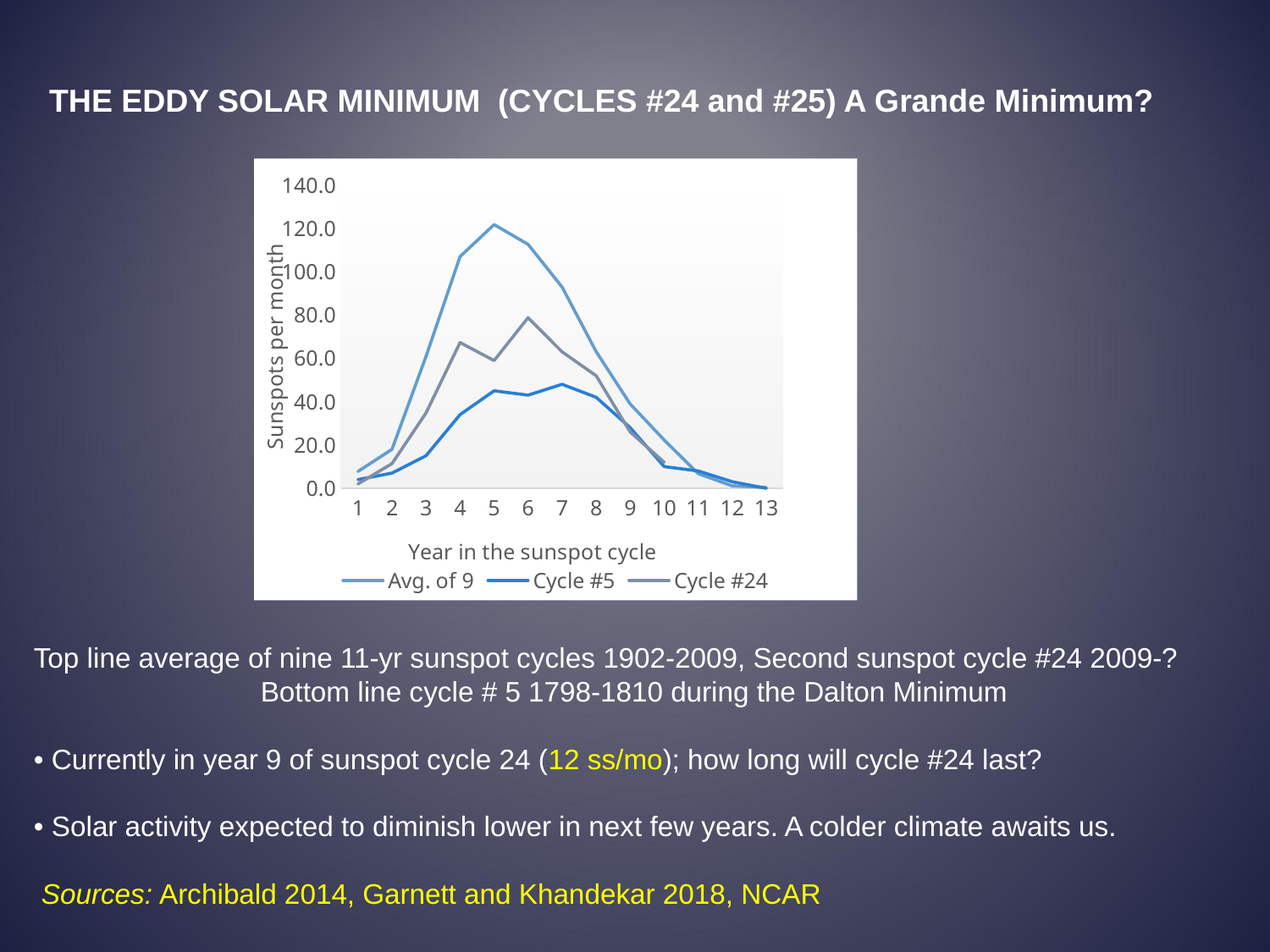
Is the value of the Cycle #5 series at year 7 greater or less than 60.0? less At year 5, which series has the larger value, Avg. of 9 or Cycle #24? Avg. of 9 In which year of the sunspot cycle does the Avg. of 9 series reach its peak? 5 What kind of chart is shown on the slide? line chart How many years are marked along the x axis of the chart? 13 How many series does the chart's legend list? 3 Which series has the lowest peak value on the chart? Cycle #5 Does the Avg. of 9 series rise or fall from year 5 to year 13? fall Which series reaches the highest peak value on the chart? Avg. of 9 Is the value of the Cycle #24 series at year 6 greater or less than 60.0? greater What is the title of the chart's y axis? Sunspots per month Is the value of the Avg. of 9 series at year 5 greater or less than 100.0? greater